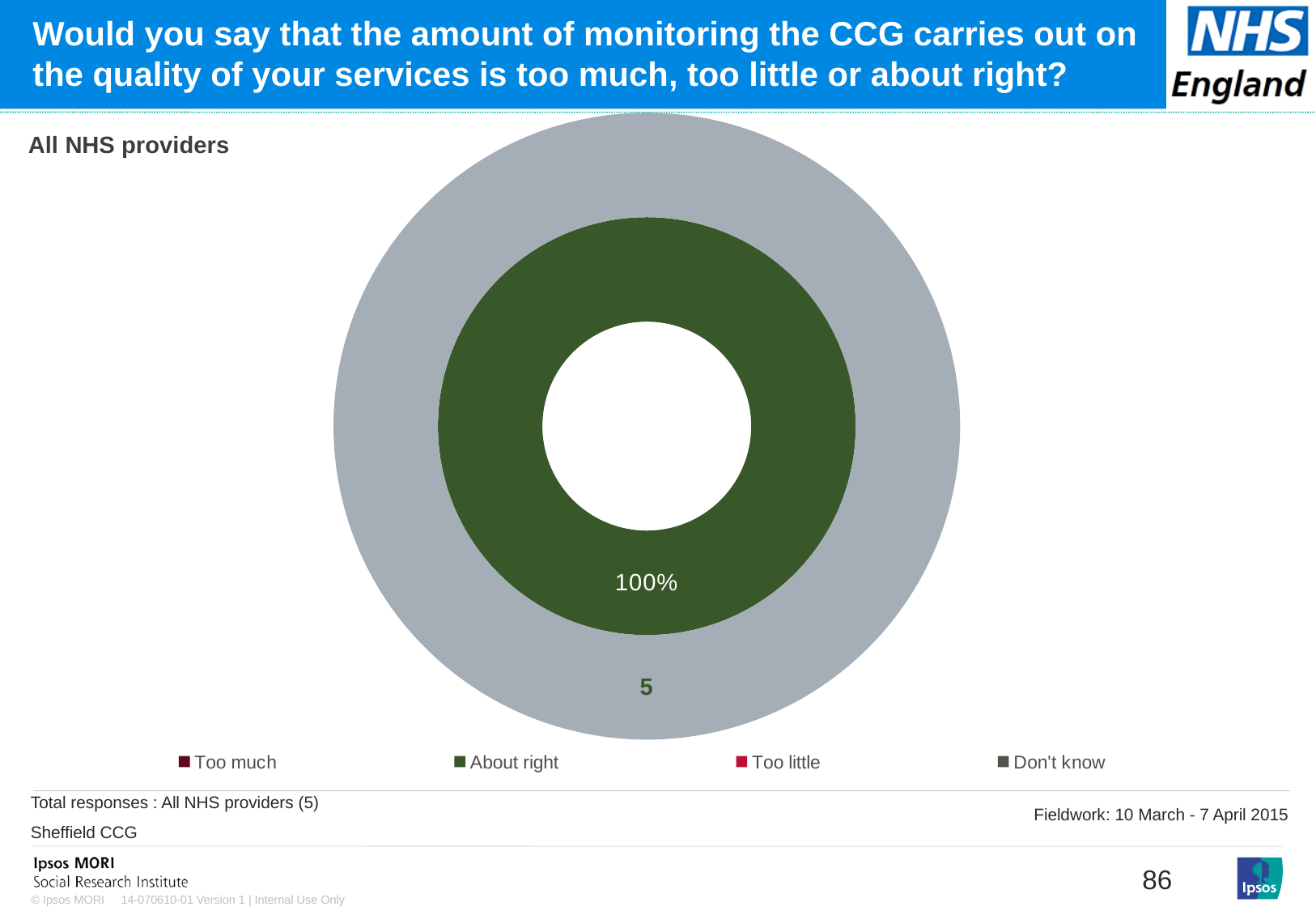
Which CCG does this chart relate to? Sheffield CCG Which colour represents 'About right' in the legend? Green What percentage of All NHS providers said the amount of monitoring is 'About right'? 100% What is the label above the chart identifying the group of respondents? All NHS providers What kind of chart is shown on the slide? Doughnut chart What share of the doughnut does the 'About right' slice take up? 100% Is the value for 'About right' greater or less than 50%? greater Which response category accounts for the largest share of the doughnut chart? About right How many slices with a printed data label appear in the doughnut chart? 2 How many total responses are there from All NHS providers? 5 How many response categories does the legend list? 4 What number is printed in the grey outer ring of the chart? 5